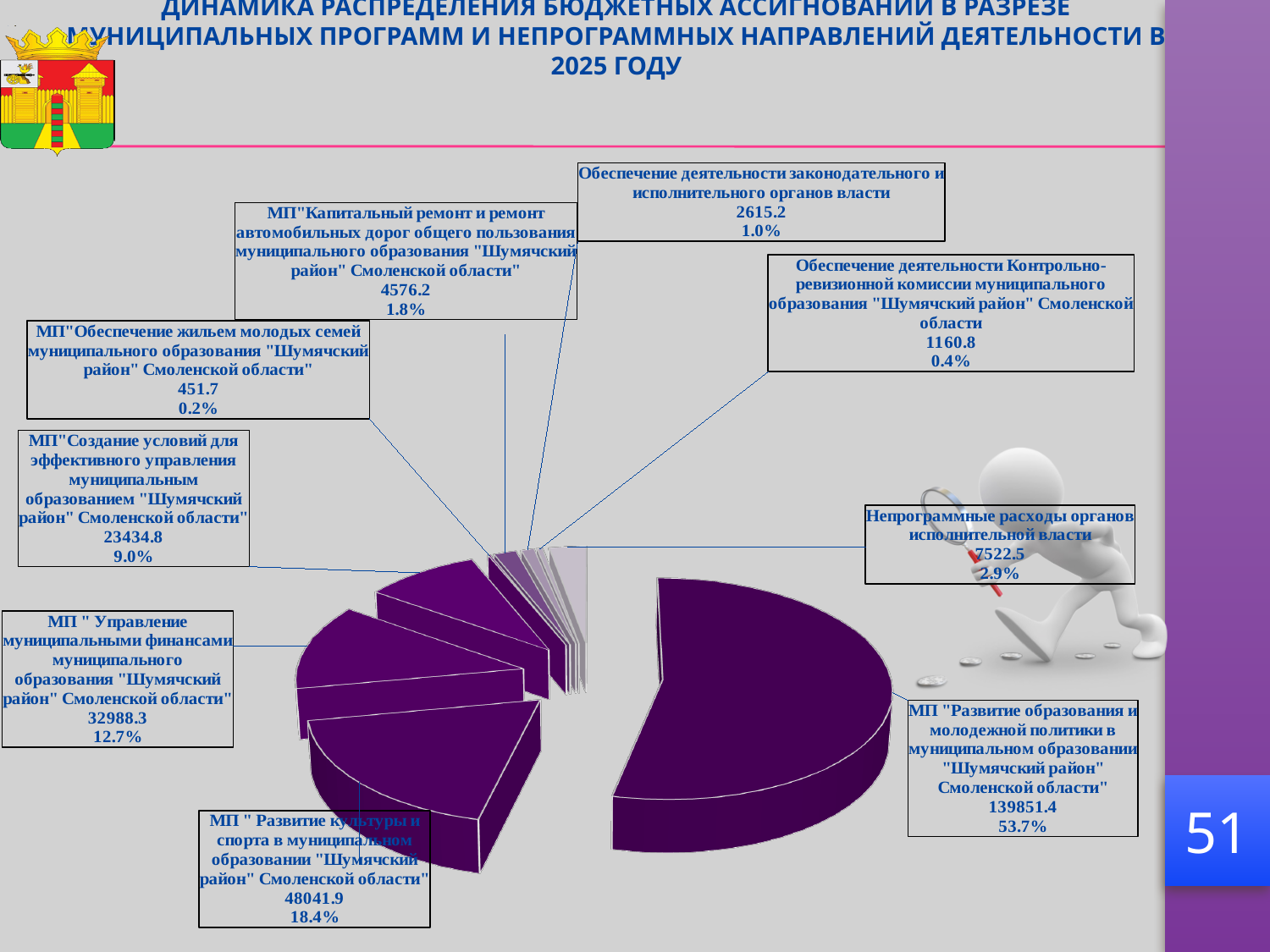
What is the value shown for Непрограммные расходы органов исполнительной власти? 7522.5 What percentage is shown for МП "Управление муниципальными финансами"? 12.7% Which category has the smallest slice of the pie? МП "Обеспечение жильем молодых семей" Which category has the largest slice of the pie? МП "Развитие образования и молодежной политики" What is the difference between the values for МП "Развитие культуры и спорта" (48041.9) and МП "Управление муниципальными финансами" (32988.3)? 15053.6 What is the value shown for МП "Развитие образования и молодежной политики"? 139851.4 Which is larger: the value for МП "Капитальный ремонт и ремонт автомобильных дорог" or for Обеспечение деятельности законодательного и исполнительного органов власти? МП "Капитальный ремонт и ремонт автомобильных дорог" What percentage is shown for Обеспечение деятельности Контрольно-ревизионной комиссии? 0.4% What share of the pie does МП "Развитие образования и молодежной политики" take? 53.7% What is the value shown for МП "Развитие культуры и спорта"? 48041.9 How many slices (categories) does the pie chart have? 9 What kind of chart is shown on the slide? pie chart